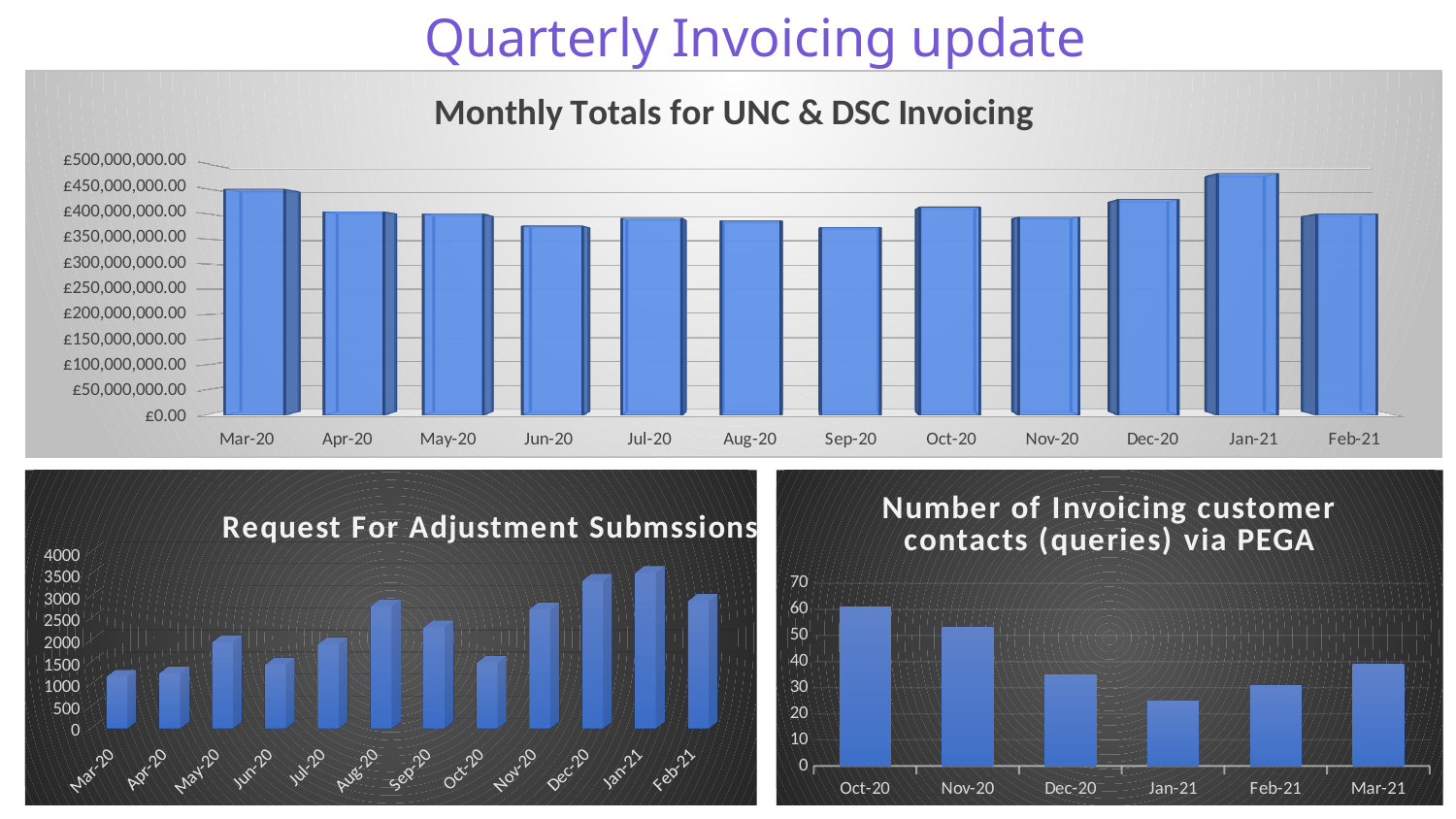
In the 'Monthly Totals for UNC & DSC Invoicing' chart, is the value for Jun-20 greater or less than £400,000,000.00? less In the 'Request For Adjustment Submssions' chart, is the value for Mar-20 greater or less than 1500? less In the 'Number of Invoicing customer contacts (queries) via PEGA' chart, which month has the highest value? Oct-20 In the 'Monthly Totals for UNC & DSC Invoicing' chart, is the value for Mar-20 greater or less than £400,000,000.00? greater How many months are shown in the 'Number of Invoicing customer contacts (queries) via PEGA' chart? 6 In the 'Monthly Totals for UNC & DSC Invoicing' chart, which month has the highest value? Jan-21 In the 'Monthly Totals for UNC & DSC Invoicing' chart, which is larger, Mar-20 or Apr-20? Mar-20 In the 'Number of Invoicing customer contacts (queries) via PEGA' chart, which month has the lowest value? Jan-21 In the 'Request For Adjustment Submssions' chart, which month has the highest value? Jan-21 What type of chart is the 'Number of Invoicing customer contacts (queries) via PEGA' chart? Bar chart How many months are shown in the 'Monthly Totals for UNC & DSC Invoicing' chart? 12